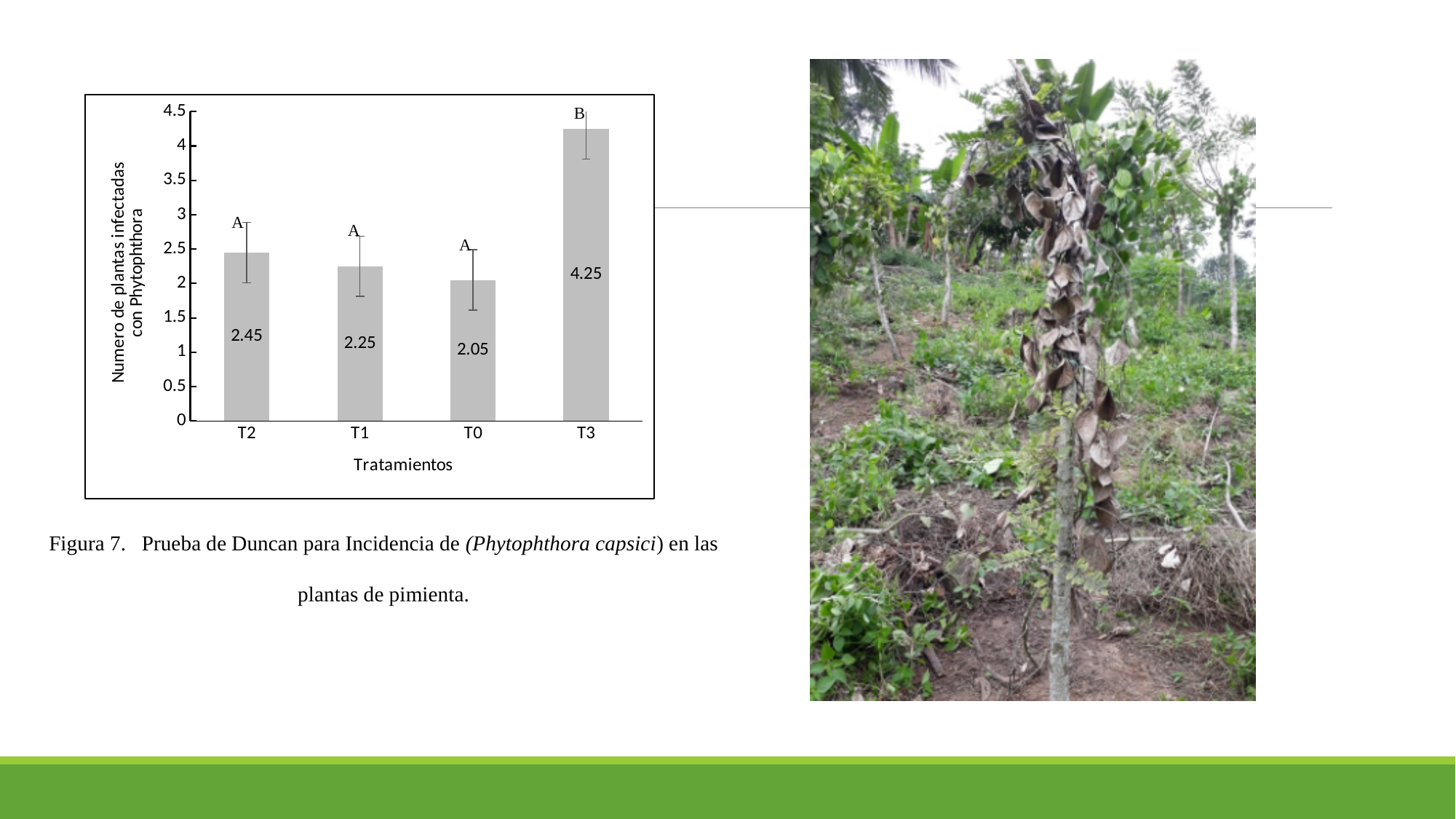
What is the difference between the values for T3 and T0? 2.2 What is the value for T2? 2.45 Which treatment has the highest number of infected plants? T3 Which treatment has the lowest number of infected plants? T0 What is the value for T3? 4.25 How many treatments are shown on the x axis? 4 Which is larger, the value for T2 or the value for T0? T2 What is the difference between the values for T2 and T1? 0.2 What is the value for T0? 2.05 What is the value for T1? 2.25 What kind of chart is shown on the slide? Bar chart What is the x-axis title of the chart? Tratamientos